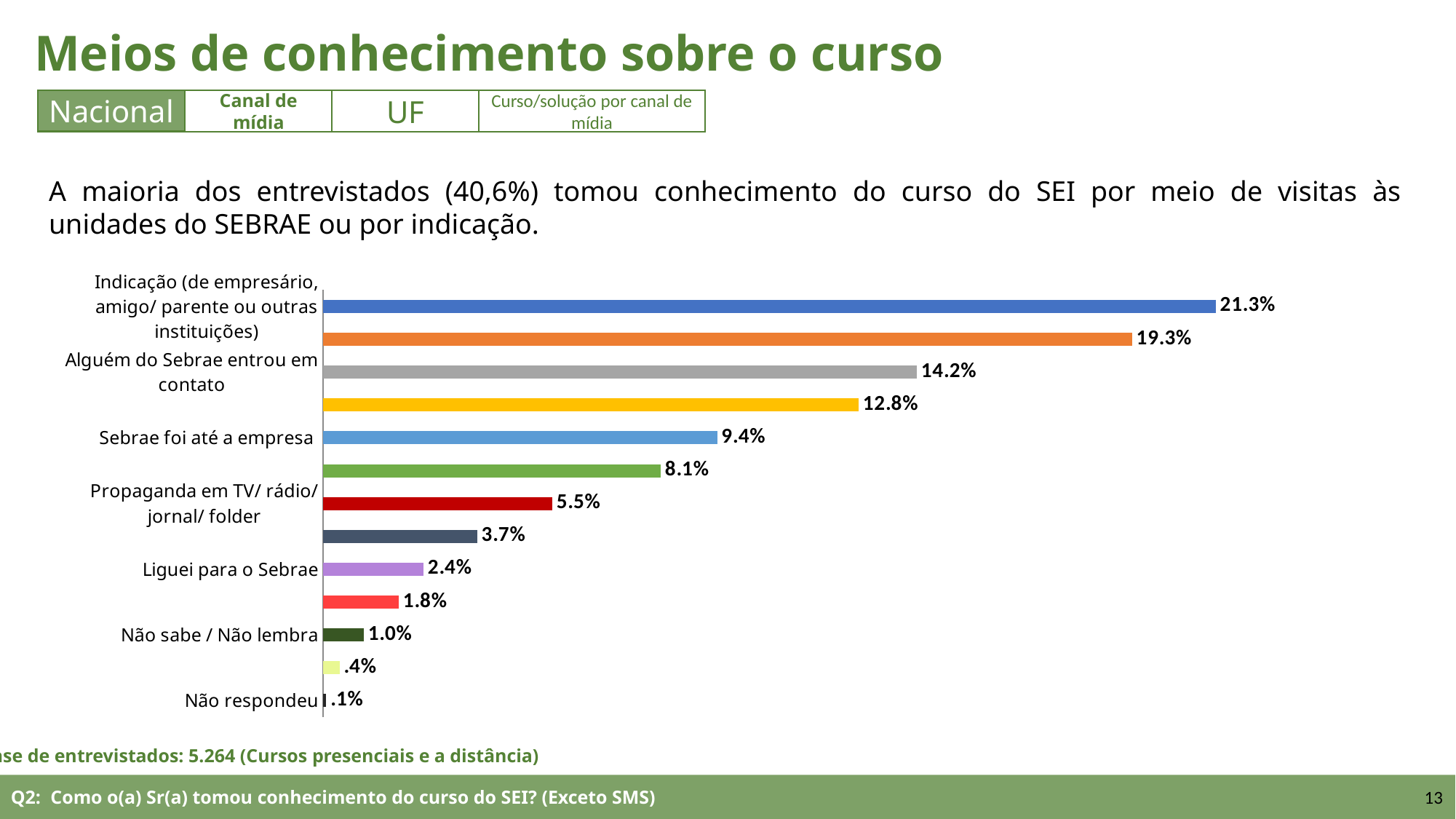
What kind of chart is shown on the slide? Bar chart What value is shown for 'Sebrae foi até a empresa'? 9.4% Which category has the highest value in the chart? Indicação (de empresário, amigo/ parente ou outras instituições) What value is shown for 'Propaganda em TV/ rádio/ jornal/ folder'? 5.5% Which is larger: the value for 'Sebrae foi até a empresa' or for 'Propaganda em TV/ rádio/ jornal/ folder'? Sebrae foi até a empresa What value is shown for 'Não sabe / Não lembra'? 1.0% What value is shown for 'Liguei para o Sebrae'? 2.4% What value is shown for 'Indicação (de empresário, amigo/ parente ou outras instituições)'? 21.3% What value is shown for 'Alguém do Sebrae entrou em contato'? 14.2% What is the difference in percentage points between 'Indicação (de empresário, amigo/ parente ou outras instituições)' and 'Alguém do Sebrae entrou em contato'? 7.1 How many bars are plotted in the chart? 13 Which category has the lowest value in the chart? Não respondeu